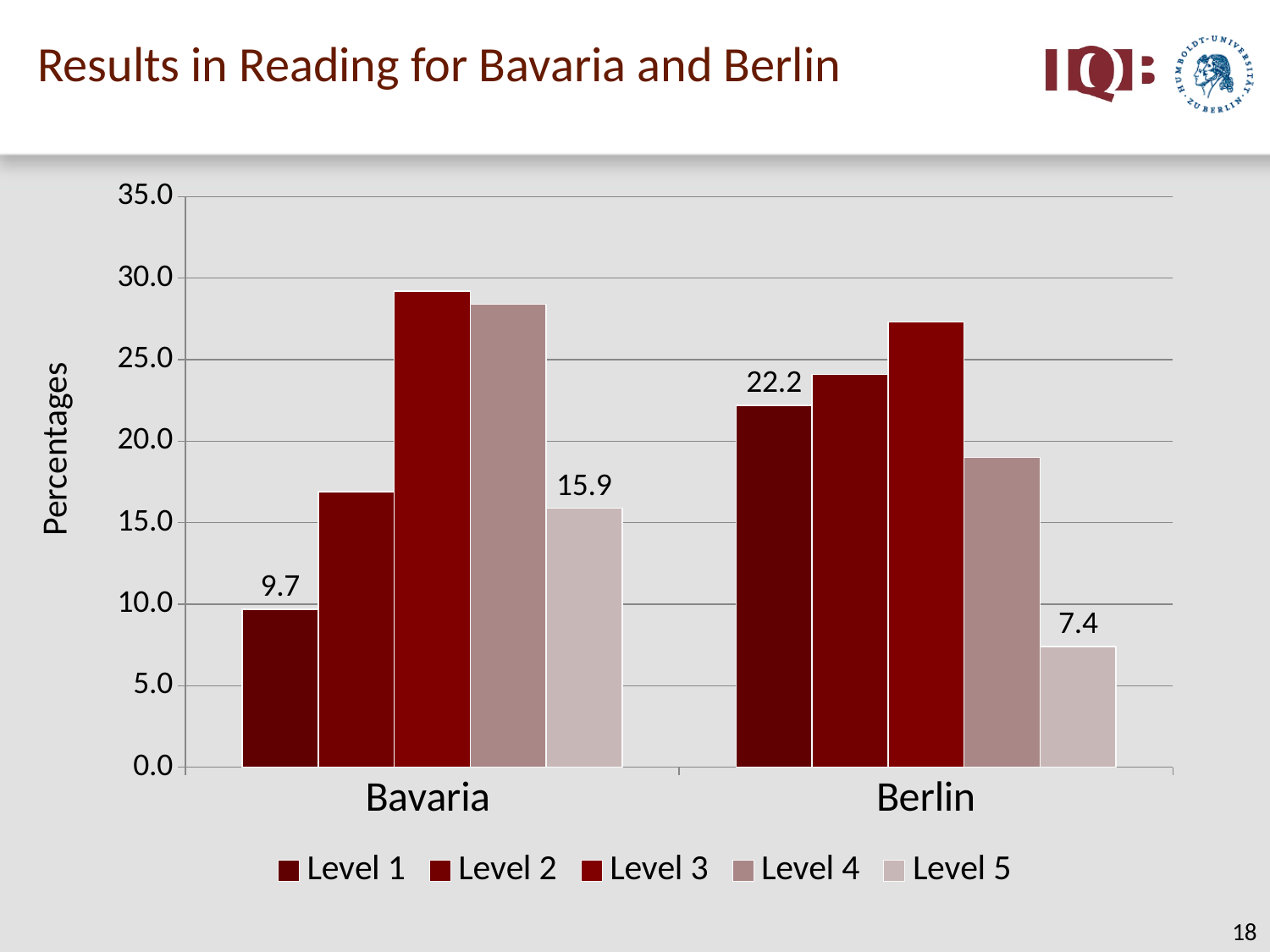
Is the value for Level 3 in Bavaria greater or less than 25.0? greater Which has the larger Level 5 value, Bavaria or Berlin? Bavaria Which level has the highest value in Berlin? Level 3 Is the value for Level 2 in Berlin greater or less than 20.0? greater How many series does the legend list? 5 What is the value for Level 1 in Berlin? 22.2 Which level has the lowest value in Bavaria? Level 1 What is the label on the vertical axis? Percentages What is the value for Level 1 in Bavaria? 9.7 What is the value for Level 5 in Bavaria? 15.9 What is the value for Level 5 in Berlin? 7.4 What is the difference between the Level 1 values for Berlin and Bavaria? 12.5